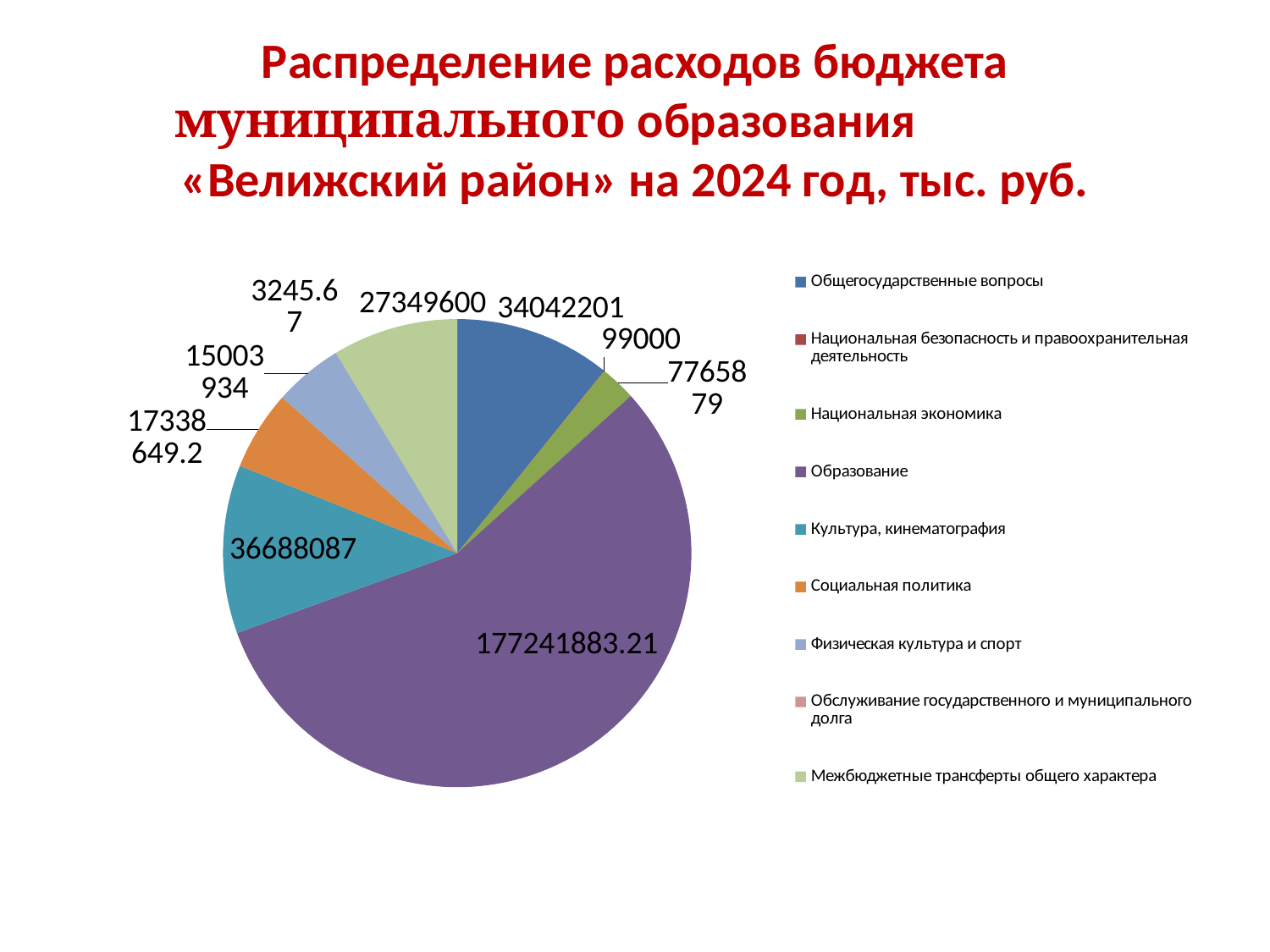
What is the value shown for Общегосударственные вопросы? 34042201 What is the value shown for Социальная политика? 17338649.2 What kind of chart is shown on the slide? pie chart Which is larger: the value for Культура, кинематография or the value for Общегосударственные вопросы? Культура, кинематография What is the value shown for Образование? 177241883.21 How many categories does the legend of the pie chart list? 9 What is the value shown for Межбюджетные трансферты общего характера? 27349600 Which category has the smallest value in the pie chart? Обслуживание государственного и муниципального долга What is the value shown for Культура, кинематография? 36688087 Which category has the largest slice of the pie chart? Образование What is the difference between the values for Культура, кинематография and Общегосударственные вопросы? 2645886 What is the value shown for Национальная безопасность и правоохранительная деятельность? 99000